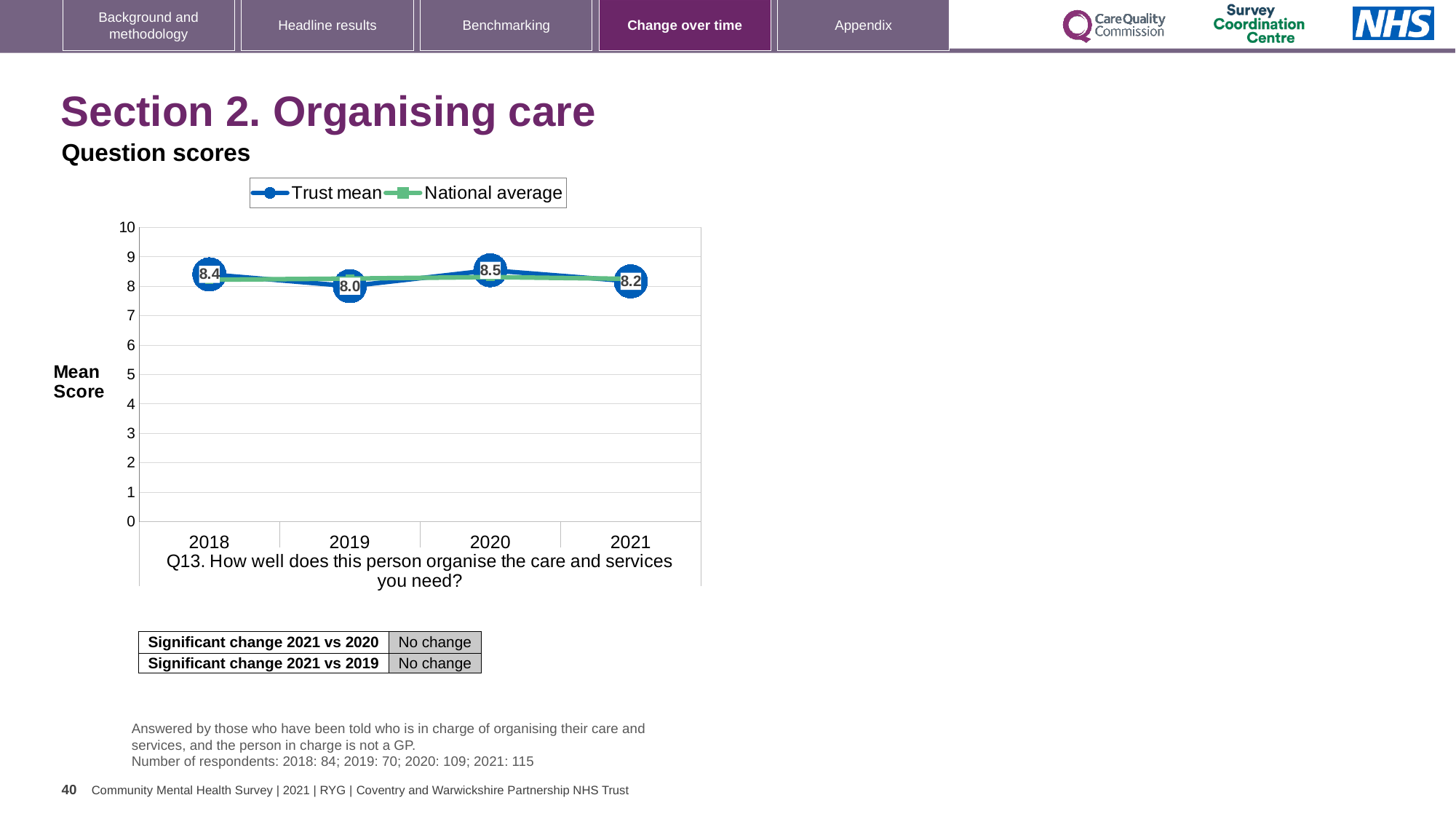
Which year has the larger Trust mean score, 2018 or 2021? 2018 In which year is the Trust mean score highest? 2020 What is the Trust mean score for 2021? 8.2 What kind of chart is shown on the slide? Line chart How many years are plotted on the x axis? 4 What is the Trust mean score for 2020? 8.5 What is the difference between the Trust mean score in 2020 and in 2019? 0.5 What is the Trust mean score for 2018? 8.4 Is the National average value for 2019 greater or less than 7? greater How many series does the legend list? 2 What is the Trust mean score for 2019? 8.0 In which year is the Trust mean score lowest? 2019